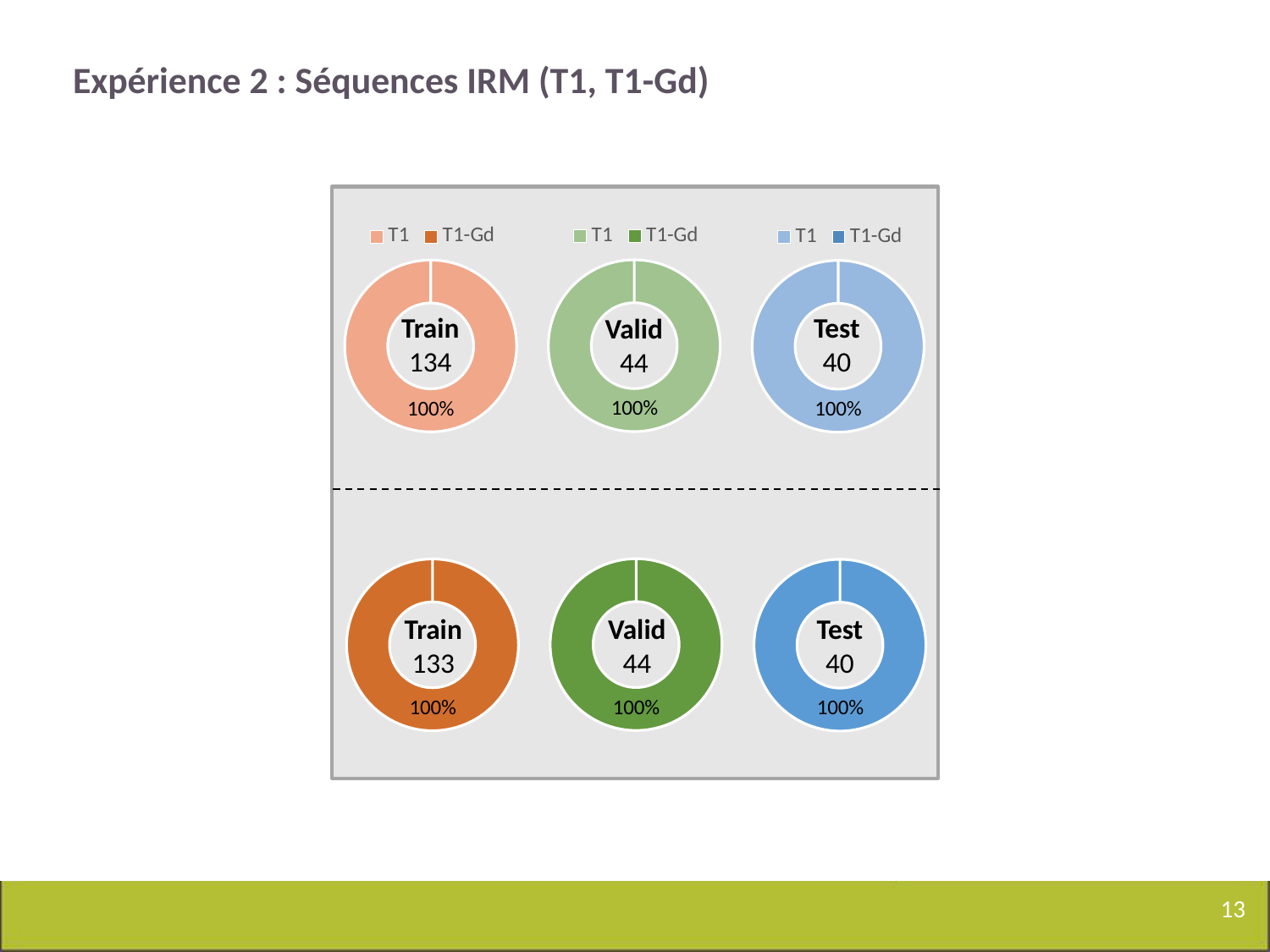
What is the difference between the Train count in the top row (134) and the Train count in the bottom row (133)? 1 In the top-left donut chart labelled Train, what number is shown in the centre? 134 How many donut charts are on the slide? 6 What kind of charts are shown on the slide? Donut (pie) charts Which of the bottom-row donut charts shows the smallest count: Train, Valid or Test? Test How many series does each legend above the charts list? 2 What percentage label is shown on the bottom-right donut chart labelled Test? 100% In the top-middle donut chart labelled Valid, what number is shown in the centre? 44 In the bottom-left donut chart labelled Train, what number is shown in the centre? 133 Is the count in the top-middle Valid chart larger or smaller than the count in the top-right Test chart? Larger Which of the top-row donut charts shows the largest count: Train, Valid or Test? Train In the top-right donut chart labelled Test, what number is shown in the centre? 40